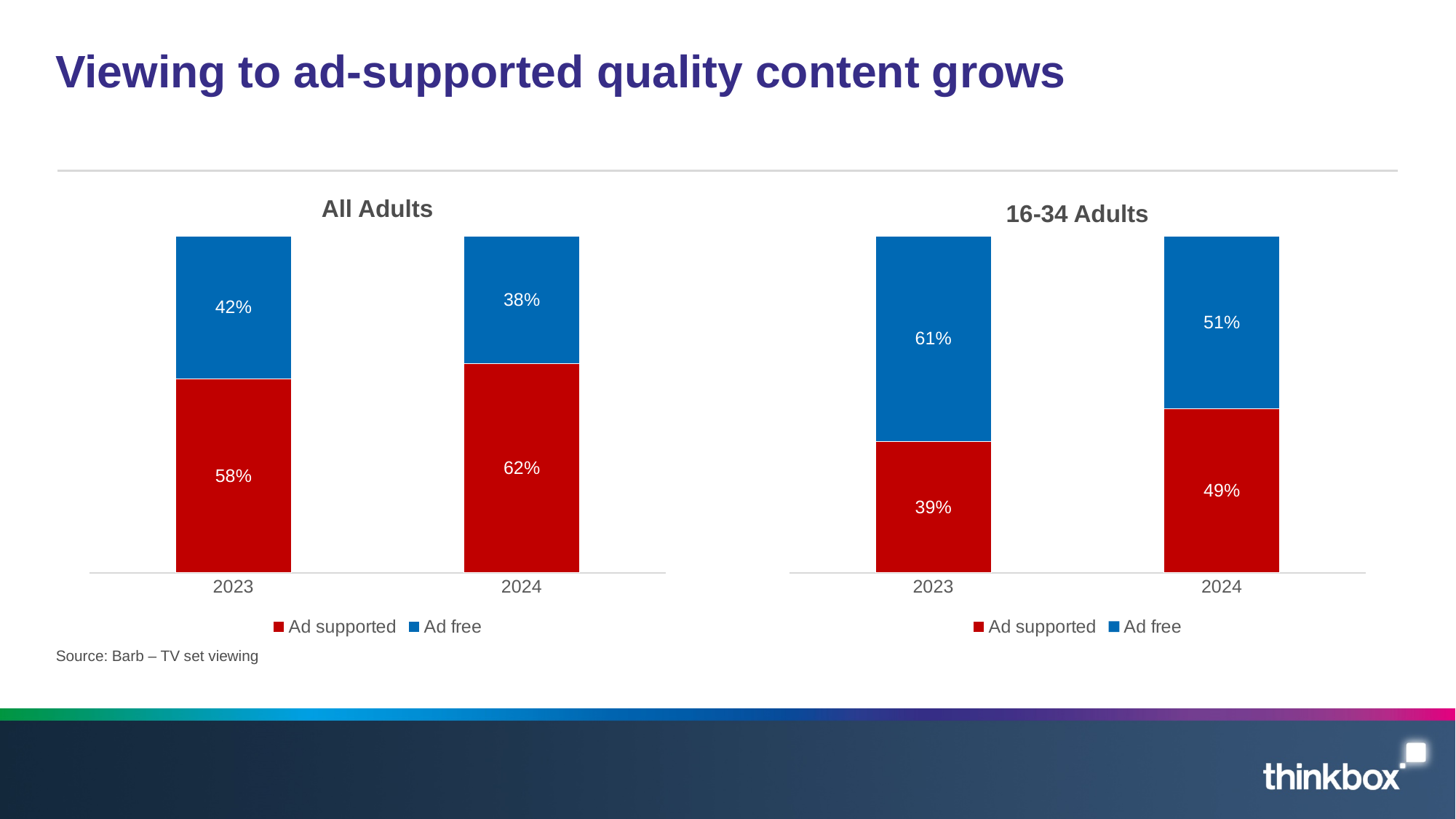
In the 16-34 Adults chart, which year has the lower Ad free value? 2024 In the All Adults chart, does the Ad supported share rise or fall from 2023 to 2024? Rise In the 16-34 Adults chart for 2024, which is larger: Ad supported or Ad free? Ad free In the All Adults chart, which year has the higher Ad supported value? 2024 In the 16-34 Adults chart, what is the Ad supported value for 2023? 39% In the All Adults chart, what is the total of the stacked bar for 2023? 100% In the 16-34 Adults chart, what is the Ad free value for 2024? 51% In the All Adults chart, what is the Ad supported value for 2023? 58% In the All Adults chart, what is the Ad free value for 2024? 38% In the 16-34 Adults chart, by how many percentage points did the Ad supported share change from 2023 to 2024? 10 percentage points How many series does the legend of the All Adults chart list? 2 What type of chart is the 16-34 Adults chart? Stacked bar chart